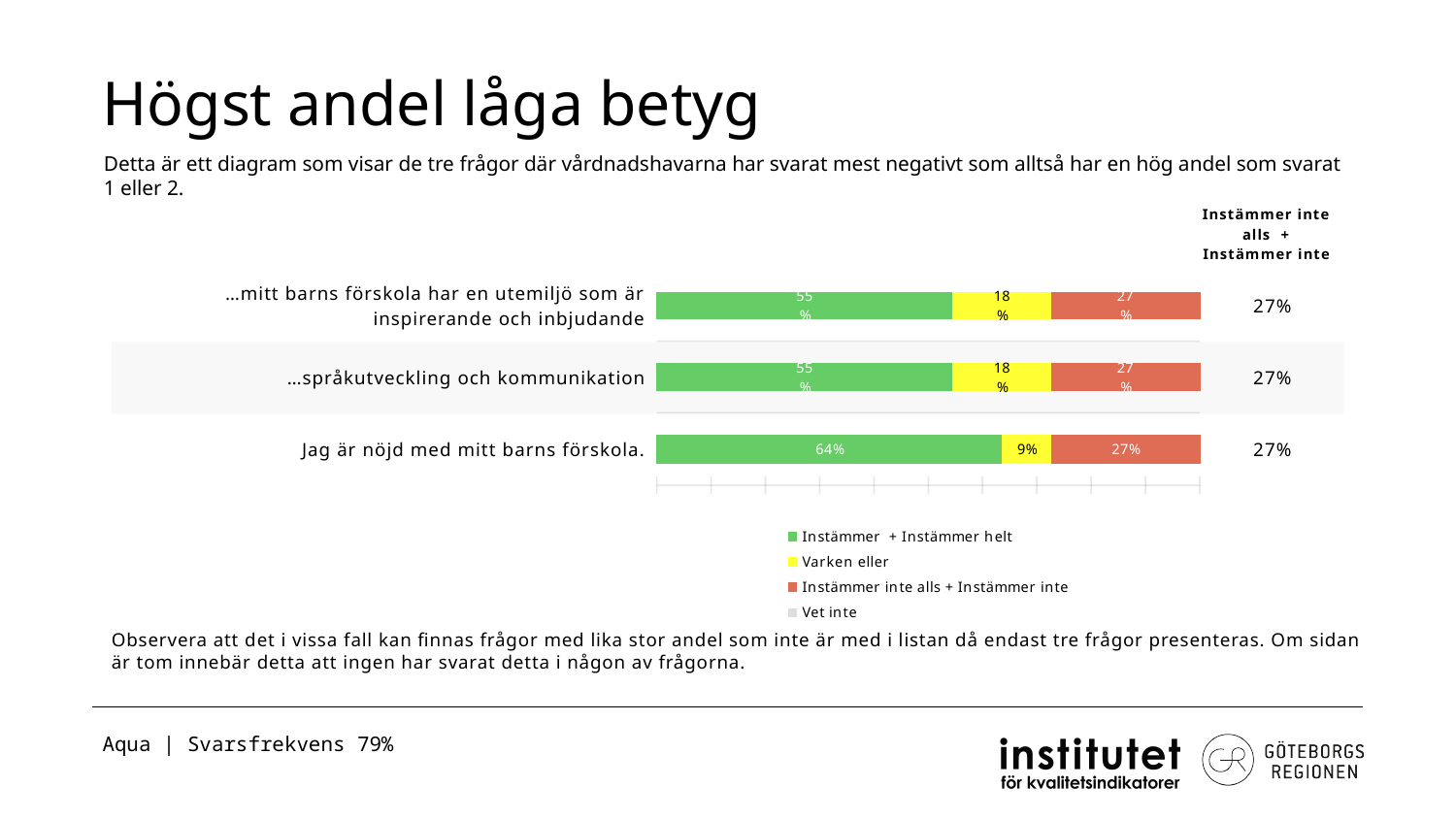
How many questions (categories) are shown in the chart? 3 What is the value of "Varken eller" for "…språkutveckling och kommunikation"? 18% How many series does the legend list? 4 Which question has the lowest share of "Varken eller"? Jag är nöjd med mitt barns förskola. What is the value of "Instämmer + Instämmer helt" for "Jag är nöjd med mitt barns förskola."? 64% What is the value of "Instämmer inte alls + Instämmer inte" for "…språkutveckling och kommunikation"? 27% What kind of chart is shown on the slide? Stacked bar chart What is the difference in "Instämmer + Instämmer helt" between "Jag är nöjd med mitt barns förskola." and "…språkutveckling och kommunikation"? 9 percentage points What is the title of the slide containing the chart? Högst andel låga betyg What is the value of "Instämmer + Instämmer helt" for "…mitt barns förskola har en utemiljö som är inspirerande och inbjudande"? 55% What is the value of "Varken eller" for "Jag är nöjd med mitt barns förskola."? 9% Which question has the highest share of "Instämmer + Instämmer helt"? Jag är nöjd med mitt barns förskola.